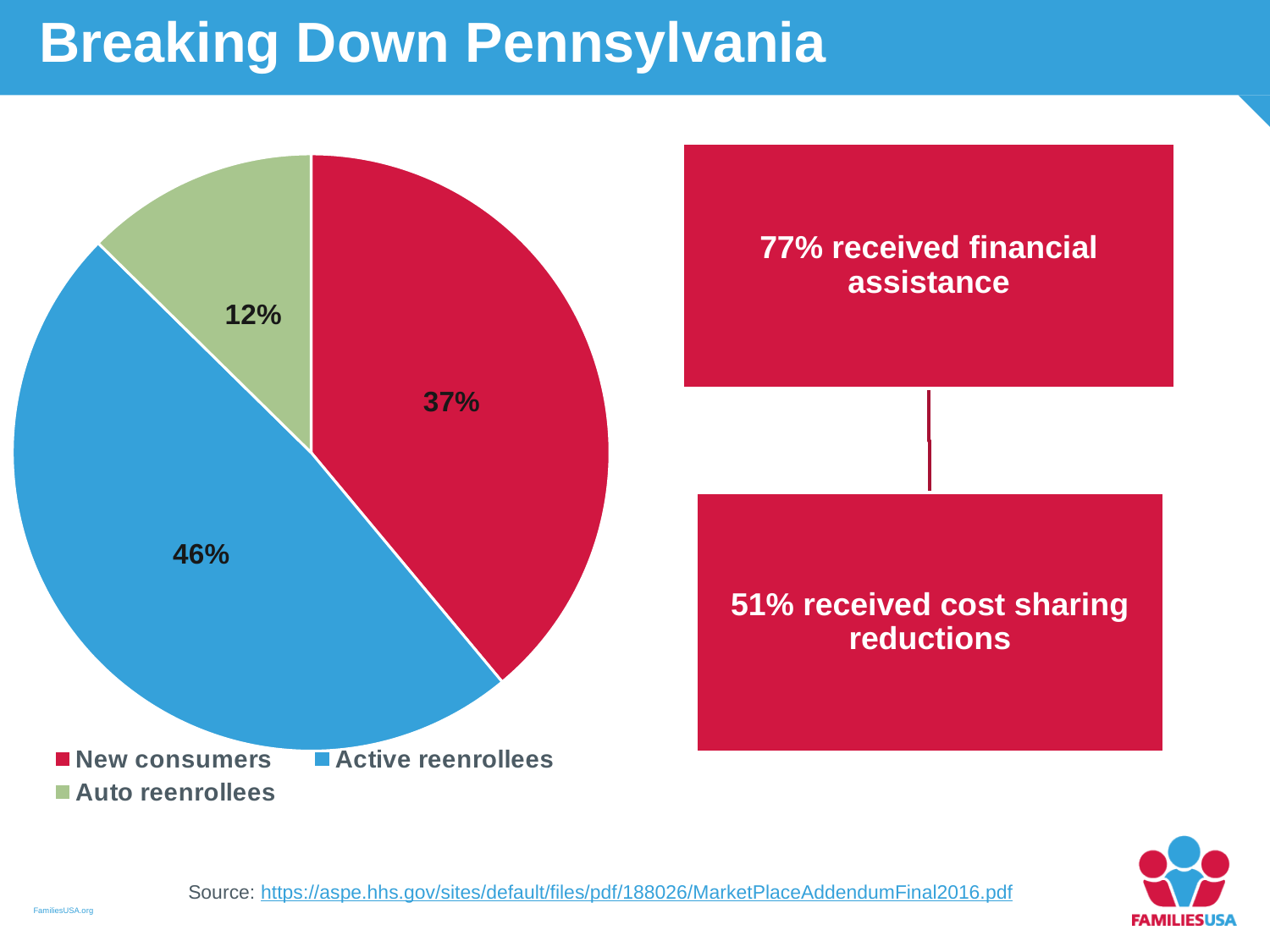
How many categories does the pie chart show? 3 What is the difference between the Active reenrollees share and the New consumers share? 9% What kind of chart is shown on the slide? Pie chart Which category is shown in green in the legend? Auto reenrollees What share of the pie is Auto reenrollees? 12% What share of the pie is New consumers? 37% What share of the pie is Active reenrollees? 46% What colour is the Active reenrollees slice? Blue Which category has the largest slice of the pie? Active reenrollees Which is larger, the share for New consumers or the share for Auto reenrollees? New consumers Which category has the smallest slice of the pie? Auto reenrollees What is the difference between the New consumers share and the Auto reenrollees share? 25%